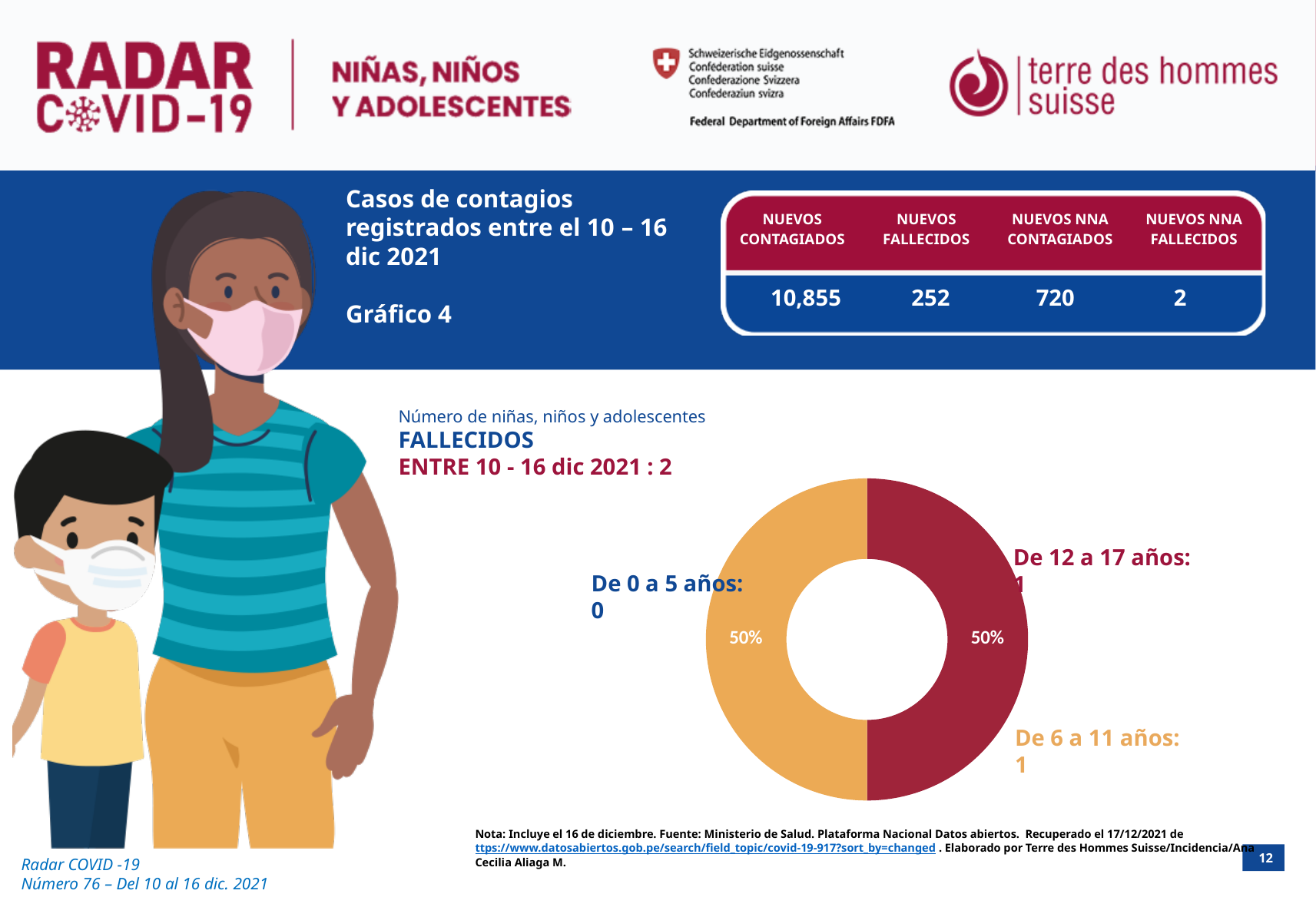
Which age category has the lowest value on the donut chart? De 0 a 5 años What is the difference between the values for 'De 6 a 11 años' and 'De 0 a 5 años'? 1 What share of the donut chart does the 'De 6 a 11 años' slice represent? 50% What is the number of deaths shown for the 'De 6 a 11 años' category? 1 What is the total number of child and adolescent deaths shown for 10 - 16 dic 2021? 2 What colour is the 'De 6 a 11 años' slice of the donut chart? Orange What is the graph number given for this chart on the slide? Gráfico 4 What kind of chart is shown on the slide? Donut (pie) chart What is the number of deaths shown for the 'De 0 a 5 años' category? 0 What share of the donut chart does the 'De 12 a 17 años' slice represent? 50% Is the value for 'De 6 a 11 años' larger than the value for 'De 0 a 5 años'? Yes How many age categories are labelled on the donut chart? 3